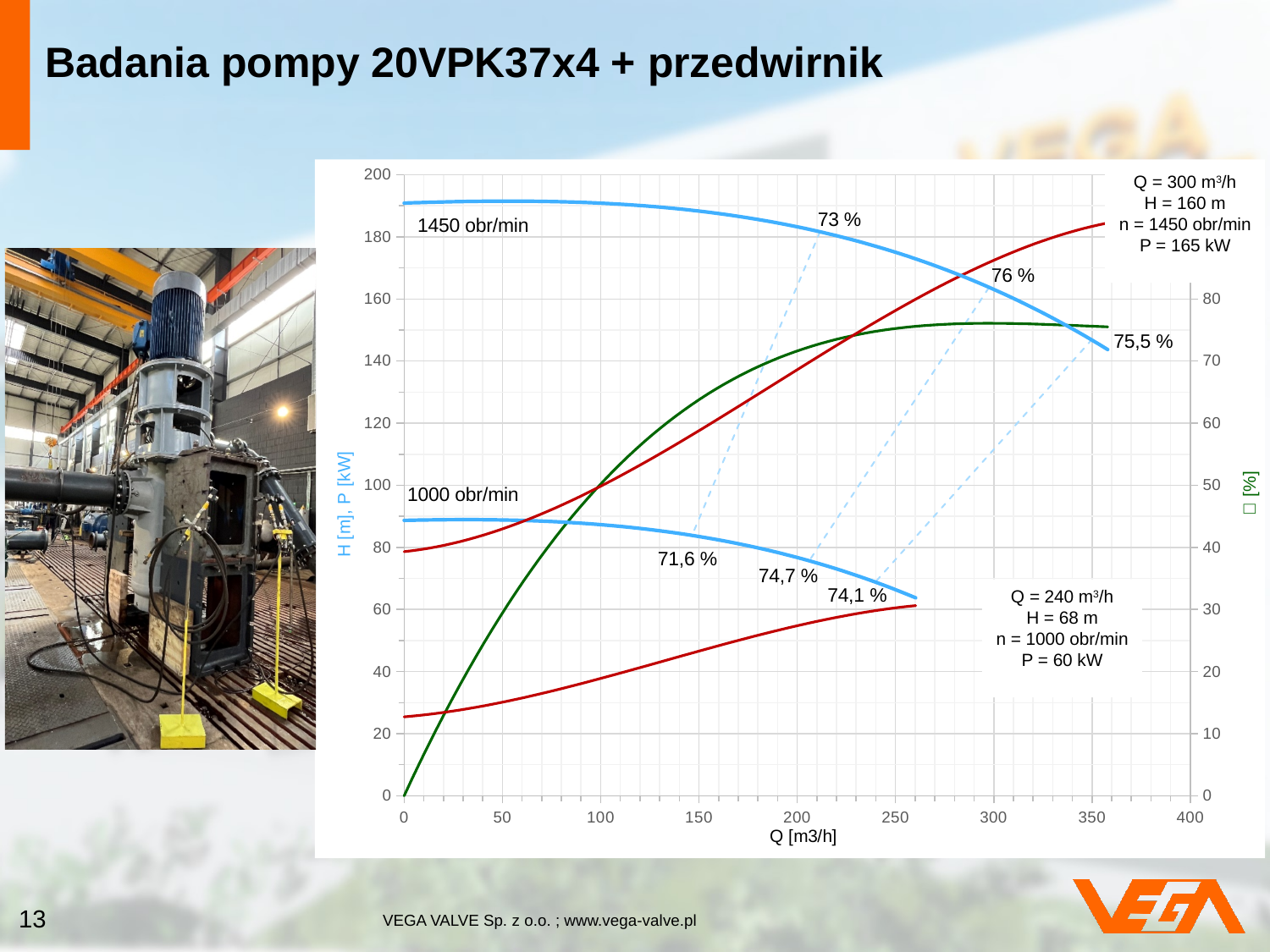
What is the highest value shown on the x axis of the chart? 400 According to the text box on the chart, what is the power P at Q = 240 m³/h and n = 1000 obr/min? 60 kW How many efficiency percentage labels are printed on the chart? 6 Is the head of the 1000 obr/min curve at Q = 0 greater or less than 100? less According to the text box on the chart, what is the head H at Q = 300 m³/h and n = 1450 obr/min? 160 m What is the highest efficiency value labelled on the chart? 76 % What is the difference in power P between the 1450 obr/min operating point (165 kW) and the 1000 obr/min operating point (60 kW) given in the text boxes? 105 kW What is the lowest efficiency value labelled on the chart? 71,6 % Which rotational speed curve reaches higher head values, 1450 obr/min or 1000 obr/min? 1450 obr/min What is the label of the x axis of the chart? Q [m3/h] What kind of chart is shown on the slide? line chart Is the head of the 1450 obr/min curve at Q = 0 greater or less than 180? greater